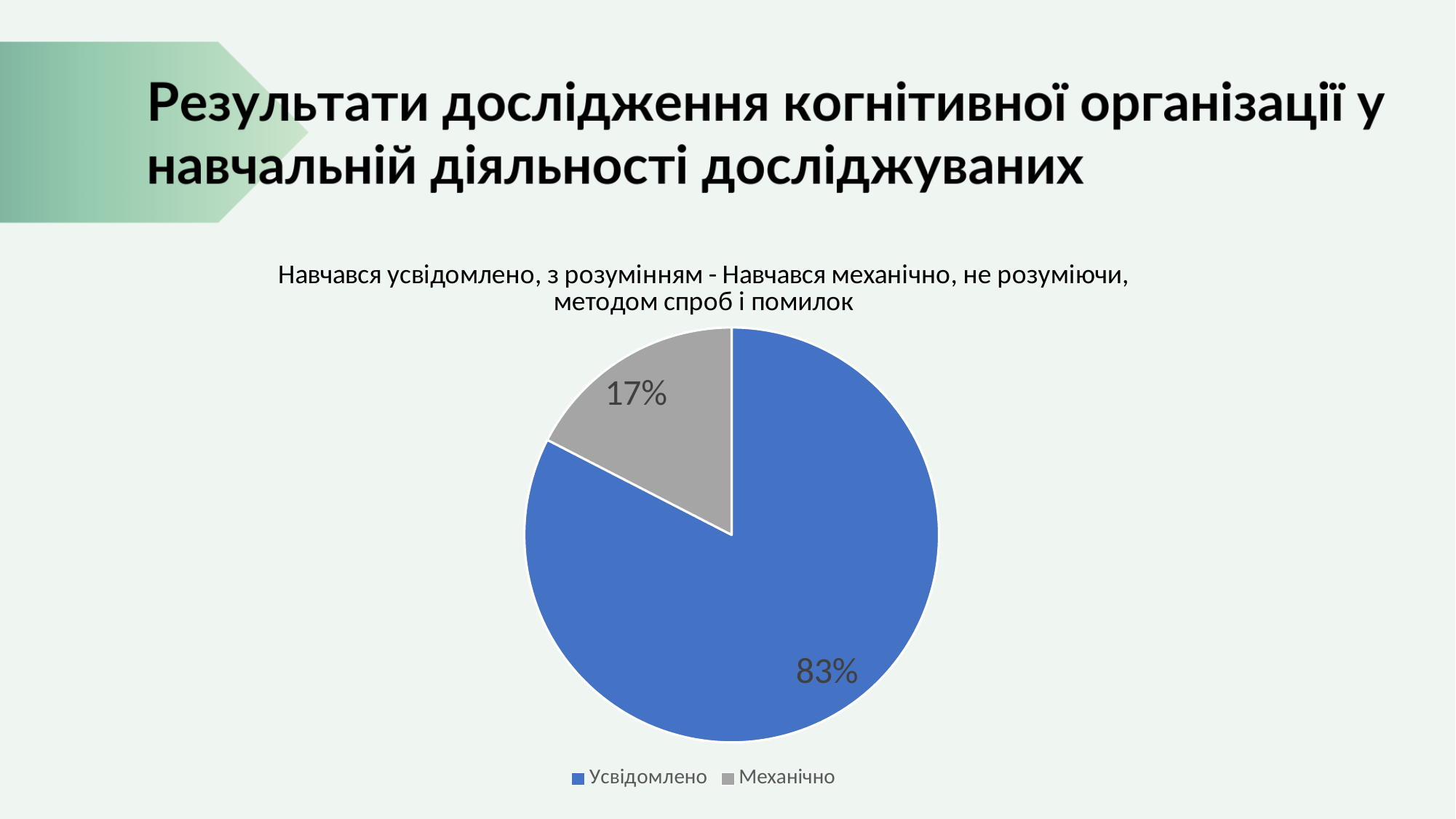
What colour is the "Механічно" slice? Grey What share of the pie does the "Усвідомлено" slice represent? 83% How many slices does the pie chart have? 2 What colour is the "Усвідомлено" slice? Blue Which category has the smallest slice of the pie? Механічно Which slice is larger, "Усвідомлено" or "Механічно"? Усвідомлено How many entries does the legend list? 2 Which category has the largest slice of the pie? Усвідомлено What is the difference in percentage points between the "Усвідомлено" and "Механічно" slices? 66 What kind of chart is shown on the slide? Pie chart What share of the pie does the "Механічно" slice represent? 17%